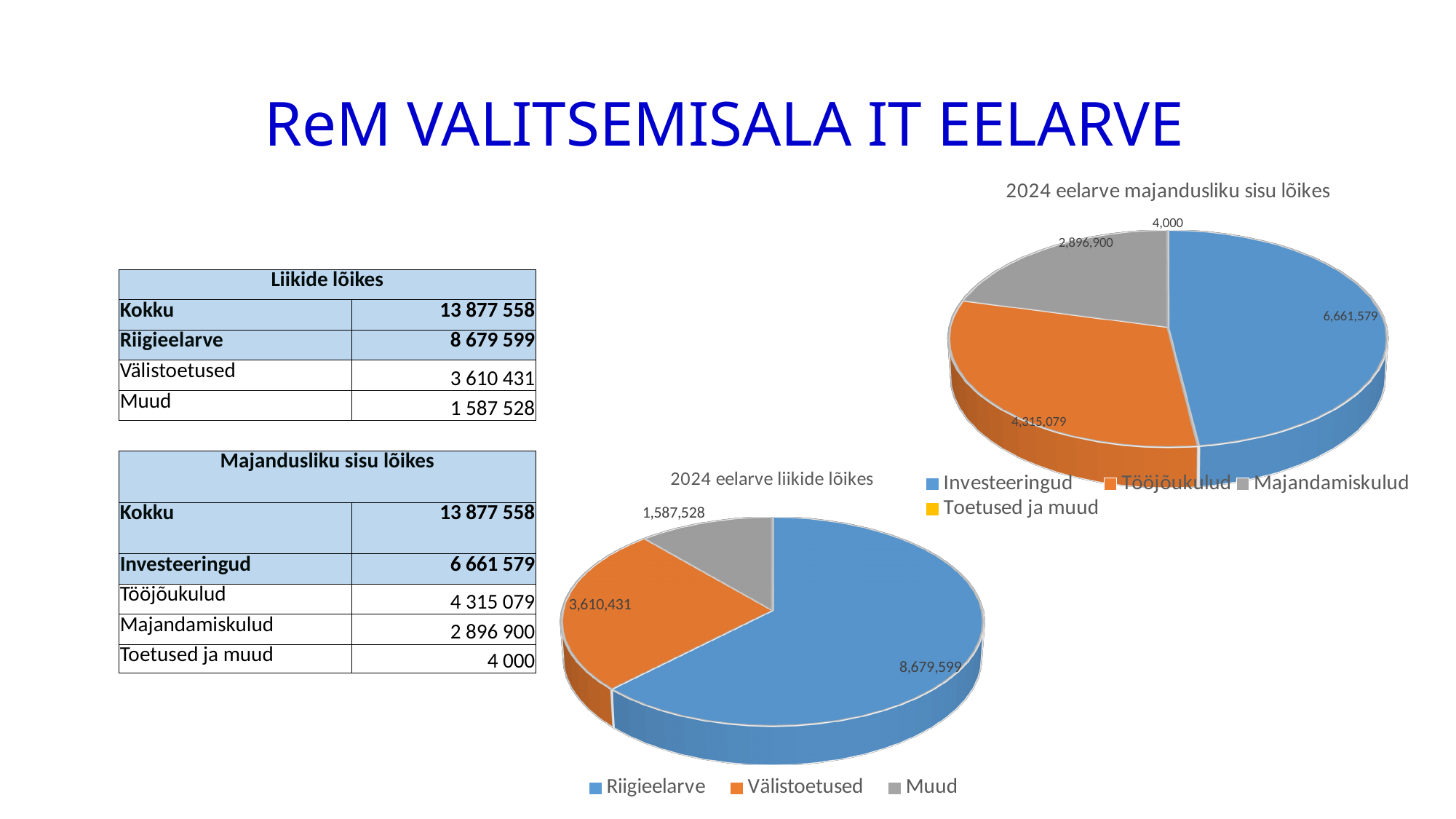
How many categories does the legend of the chart titled "2024 eelarve majandusliku sisu lõikes" list? 4 In the chart titled "2024 eelarve majandusliku sisu lõikes", which category has the smallest slice? Toetused ja muud In the chart titled "2024 eelarve liikide lõikes", what is the value for Muud? 1,587,528 In the chart titled "2024 eelarve majandusliku sisu lõikes", what is the value for Toetused ja muud? 4,000 In the chart titled "2024 eelarve liikide lõikes", what is the difference between Riigieelarve and Välistoetused? 5,069,168 In the chart titled "2024 eelarve liikide lõikes", which category has the smallest slice? Muud In the chart titled "2024 eelarve liikide lõikes", what is the value for Riigieelarve? 8,679,599 In the chart titled "2024 eelarve majandusliku sisu lõikes", what is the value for Tööjõukulud? 4,315,079 In the chart titled "2024 eelarve majandusliku sisu lõikes", what is the difference between Investeeringud and Tööjõukulud? 2,346,500 In the chart titled "2024 eelarve liikide lõikes", which is larger, Välistoetused or Muud? Välistoetused What kind of chart is the chart titled "2024 eelarve liikide lõikes"? Pie chart In the chart titled "2024 eelarve majandusliku sisu lõikes", which category has the largest slice? Investeeringud